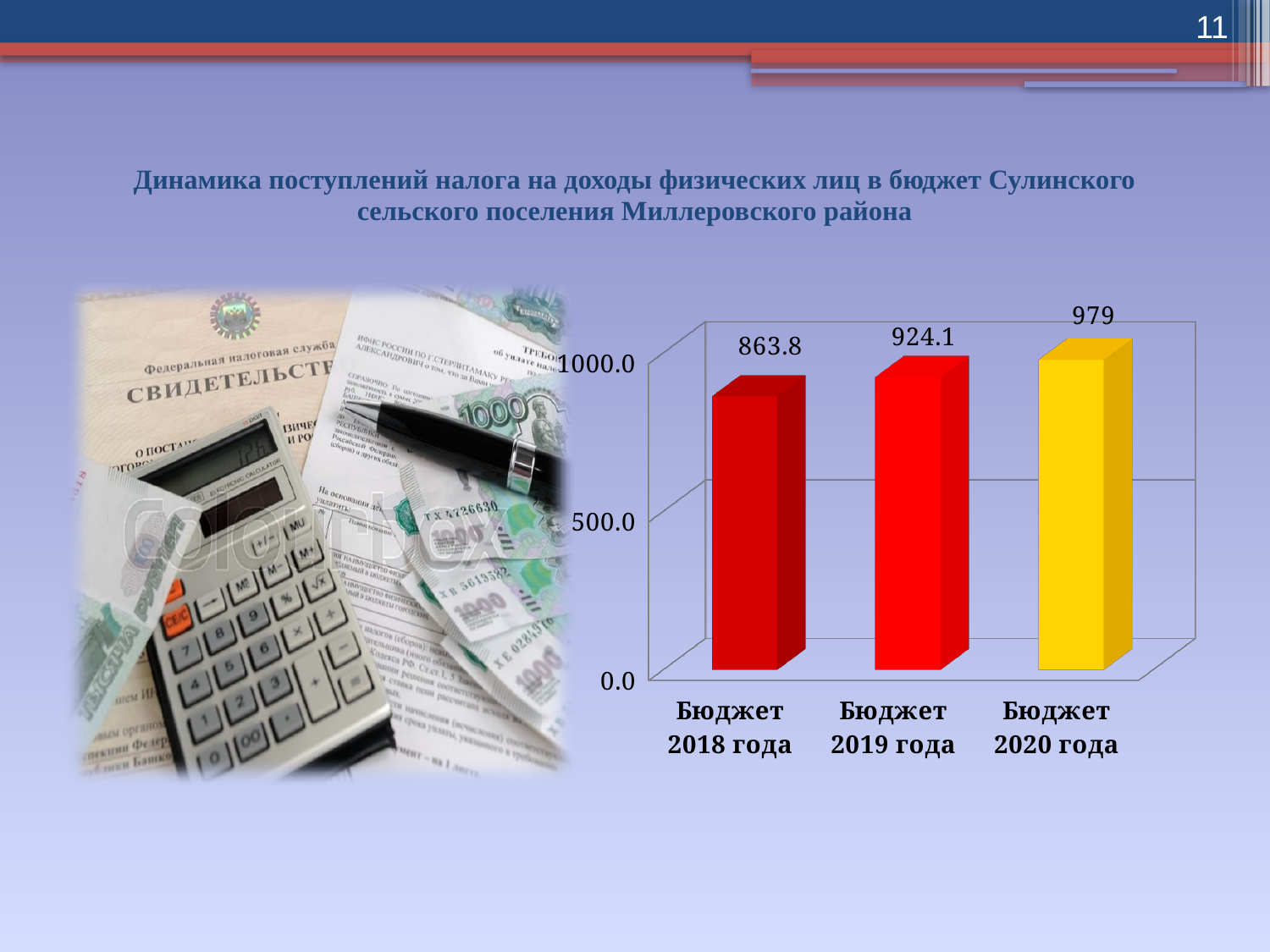
Which category has the lowest value? Бюджет 2018 года What is the value for Бюджет 2020 года? 979 What is the value for Бюджет 2018 года? 863.8 Is the value for Бюджет 2018 года greater or less than 500.0? greater What is the difference between the values for Бюджет 2019 года and Бюджет 2018 года? 60.3 What is the value for Бюджет 2019 года? 924.1 Which is larger, the value for Бюджет 2019 года or Бюджет 2020 года? Бюджет 2020 года What kind of chart is shown on the slide? bar chart Do the values rise or fall from Бюджет 2018 года to Бюджет 2020 года? rise How many categories are shown on the chart? 3 Which category has the highest value? Бюджет 2020 года What is the difference between the values for Бюджет 2020 года and Бюджет 2018 года? 115.2